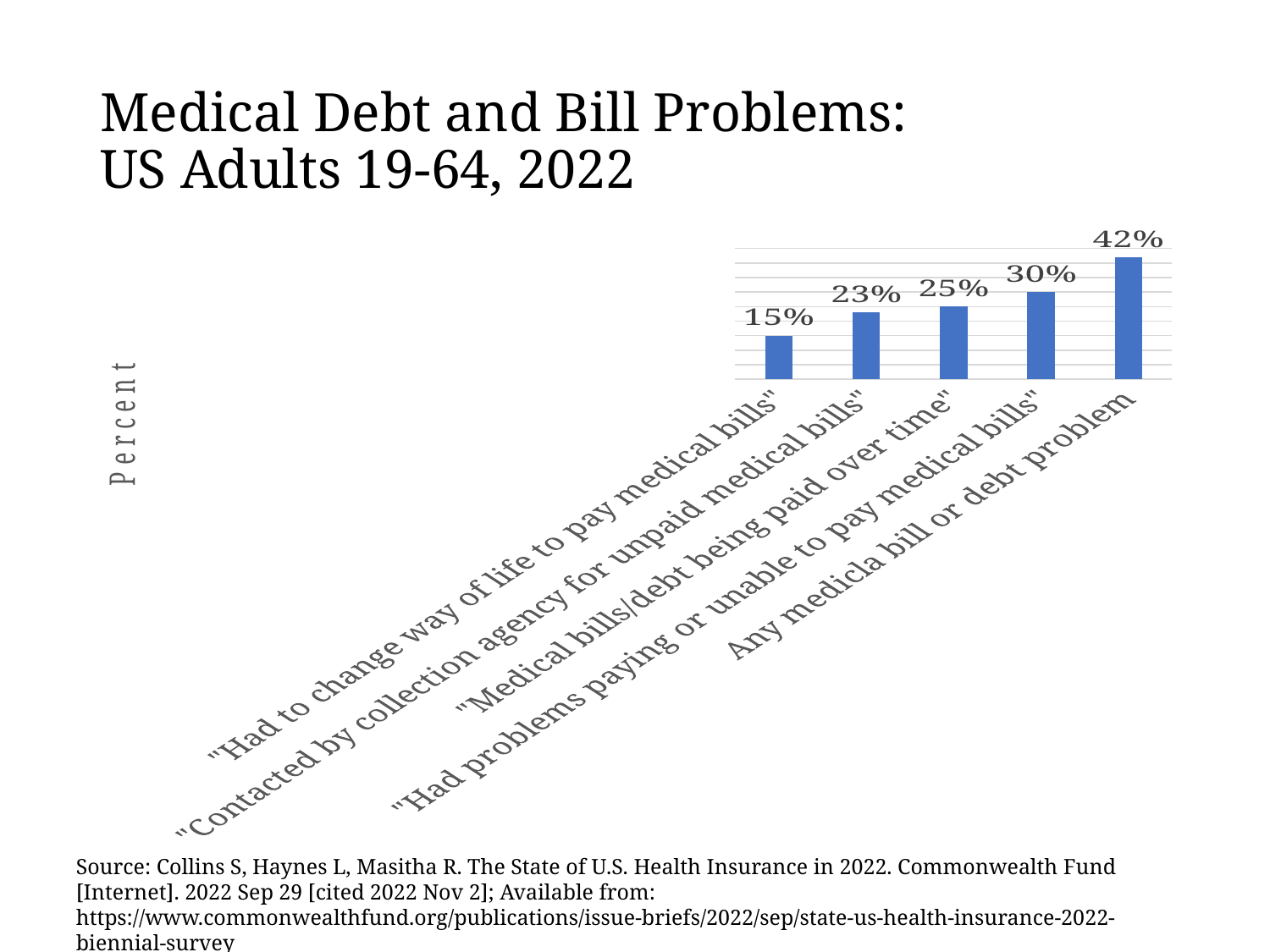
What is the value for "Medical bills/debt being paid over time"? 25% Which category has the lowest value? Had to change way of life to pay medical bills What is the value for "Any medicla bill or debt problem"? 42% What is the value for "Contacted by collection agency for unpaid medical bills"? 23% What is the value for "Had problems paying or unable to pay medical bills"? 30% Which category has the highest value? Any medicla bill or debt problem Which is larger: the value for "Had problems paying or unable to pay medical bills" or the value for "Contacted by collection agency for unpaid medical bills"? Had problems paying or unable to pay medical bills What kind of chart is shown on the slide? Bar chart What is the value for "Had to change way of life to pay medical bills"? 15% What is the difference between the values for "Any medicla bill or debt problem" and "Had to change way of life to pay medical bills"? 27% Do the values rise or fall from left to right across the categories? Rise How many categories are shown in the chart? 5